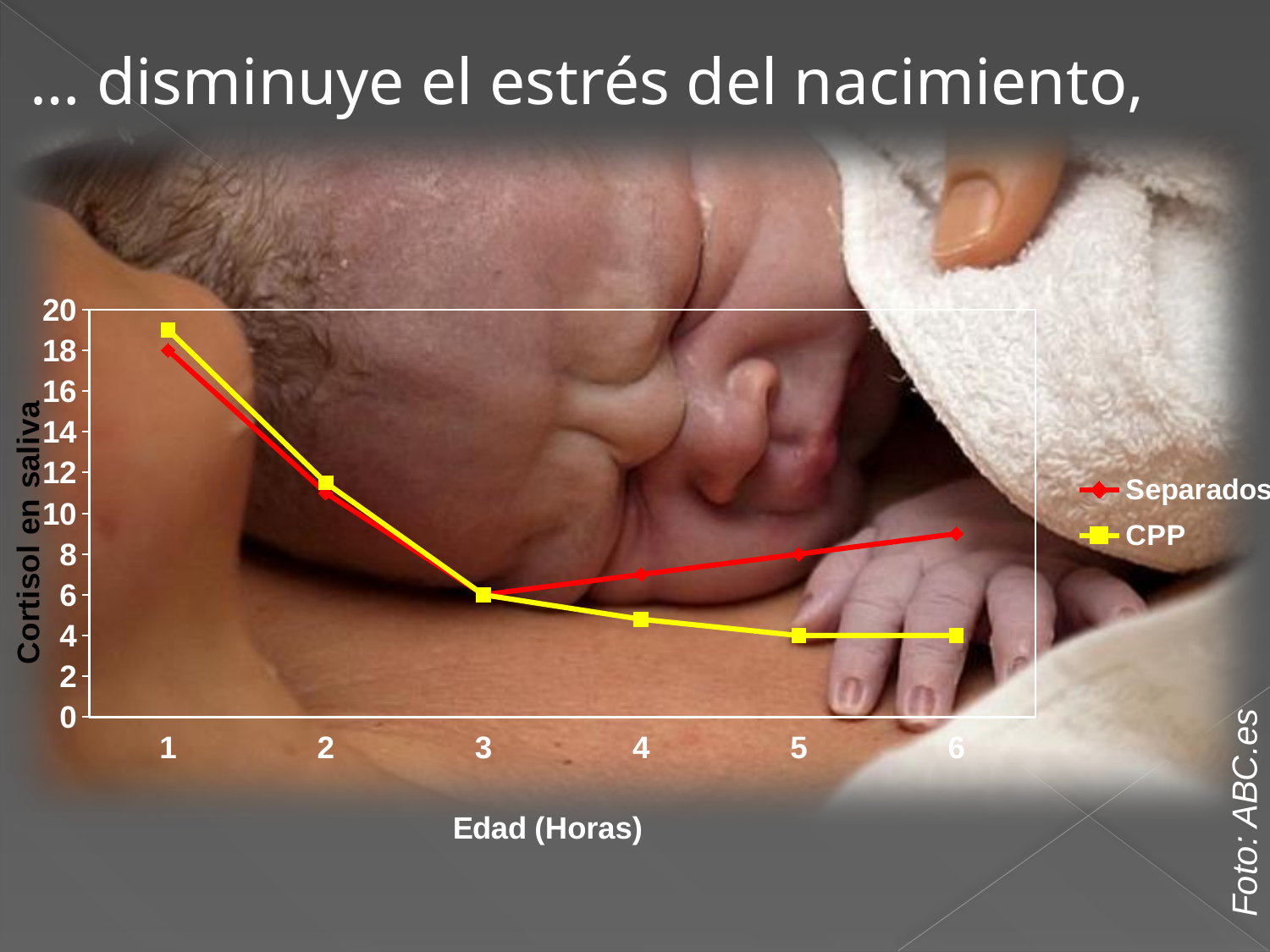
Is the value for CPP at hour 1 greater or less than 18? greater What is the title of the x axis? Edad (Horas) What is the cortisol value for the CPP series at hour 5? 4 Is the value for Separados at hour 6 greater or less than 10? less Is the value for CPP at hour 4 greater or less than 6? less What is the cortisol value for the CPP series at hour 3? 6 How many points along the x axis (Edad in hours) are plotted for each series? 6 Does the CPP series rise or fall as the hours increase along the x axis? fall What kind of chart is shown on the slide? line chart At hour 6, which series has the higher cortisol value, Separados or CPP? Separados How many series does the legend list? 2 What is the cortisol value for the Separados series at hour 1? 18